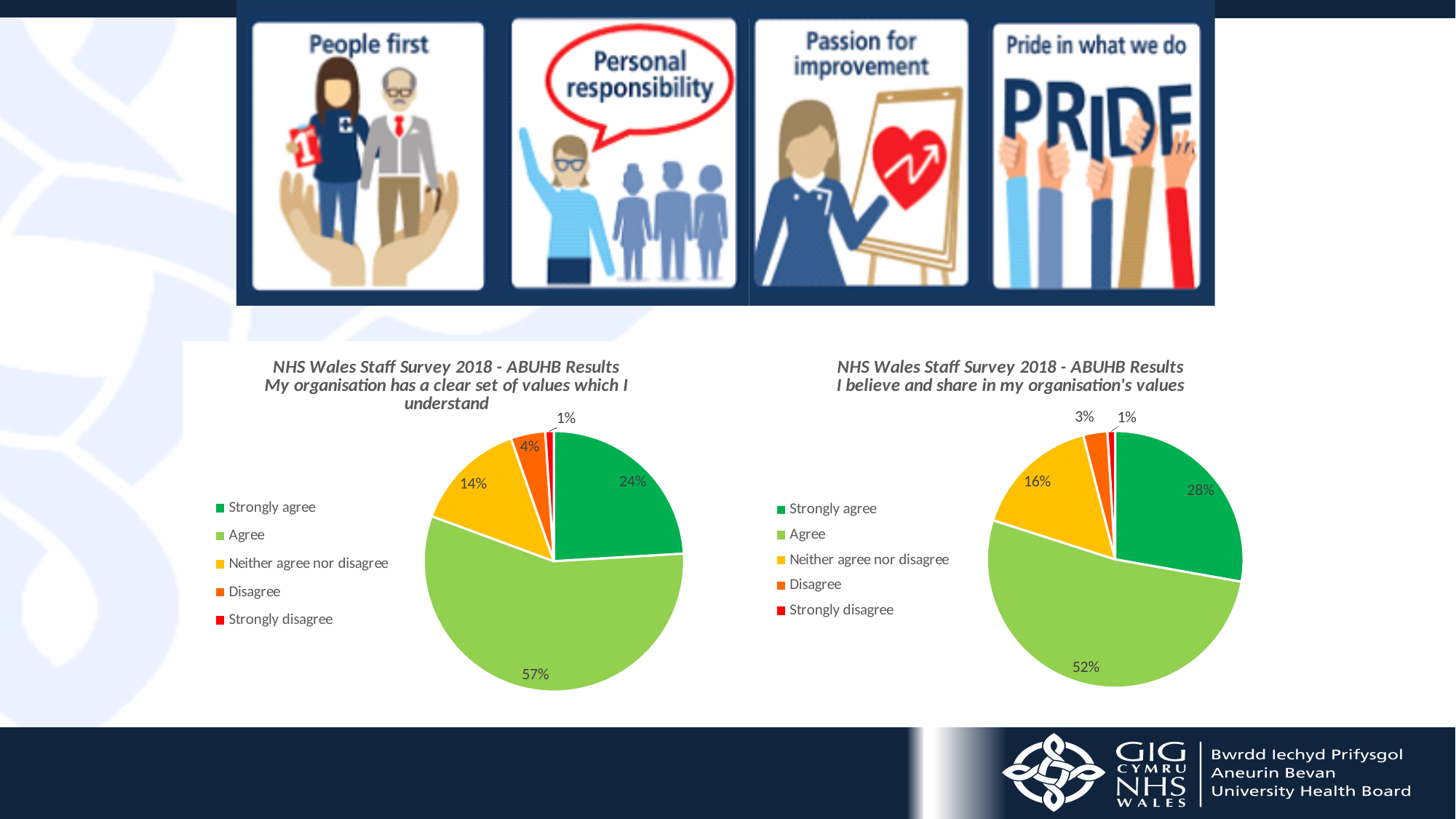
In the right pie chart ('I believe and share in my organisation's values'), which response has the largest share? Agree In the right pie chart ('I believe and share in my organisation's values'), what percentage answered 'Neither agree nor disagree'? 16% How many response categories does the legend of the right pie chart ('I believe and share in my organisation's values') list? 5 In the left pie chart ('My organisation has a clear set of values which I understand'), what is the difference between the 'Agree' and 'Strongly agree' percentages? 33% In the left pie chart ('My organisation has a clear set of values which I understand'), what percentage answered 'Strongly agree'? 24% In the left pie chart ('My organisation has a clear set of values which I understand'), what percentage answered 'Disagree'? 4% Which chart has the larger 'Strongly agree' share: the left chart ('clear set of values') or the right chart ('believe and share in values')? The right chart In the right pie chart ('I believe and share in my organisation's values'), what colour represents 'Neither agree nor disagree'? Yellow What type of chart is used for the 'NHS Wales Staff Survey 2018 - ABUHB Results' data on this slide? Pie chart In the left pie chart ('My organisation has a clear set of values which I understand'), which response has the smallest share? Strongly disagree In the left pie chart ('My organisation has a clear set of values which I understand'), what percentage of respondents answered 'Agree'? 57% In the right pie chart ('I believe and share in my organisation's values'), what percentage answered 'Strongly agree'? 28%